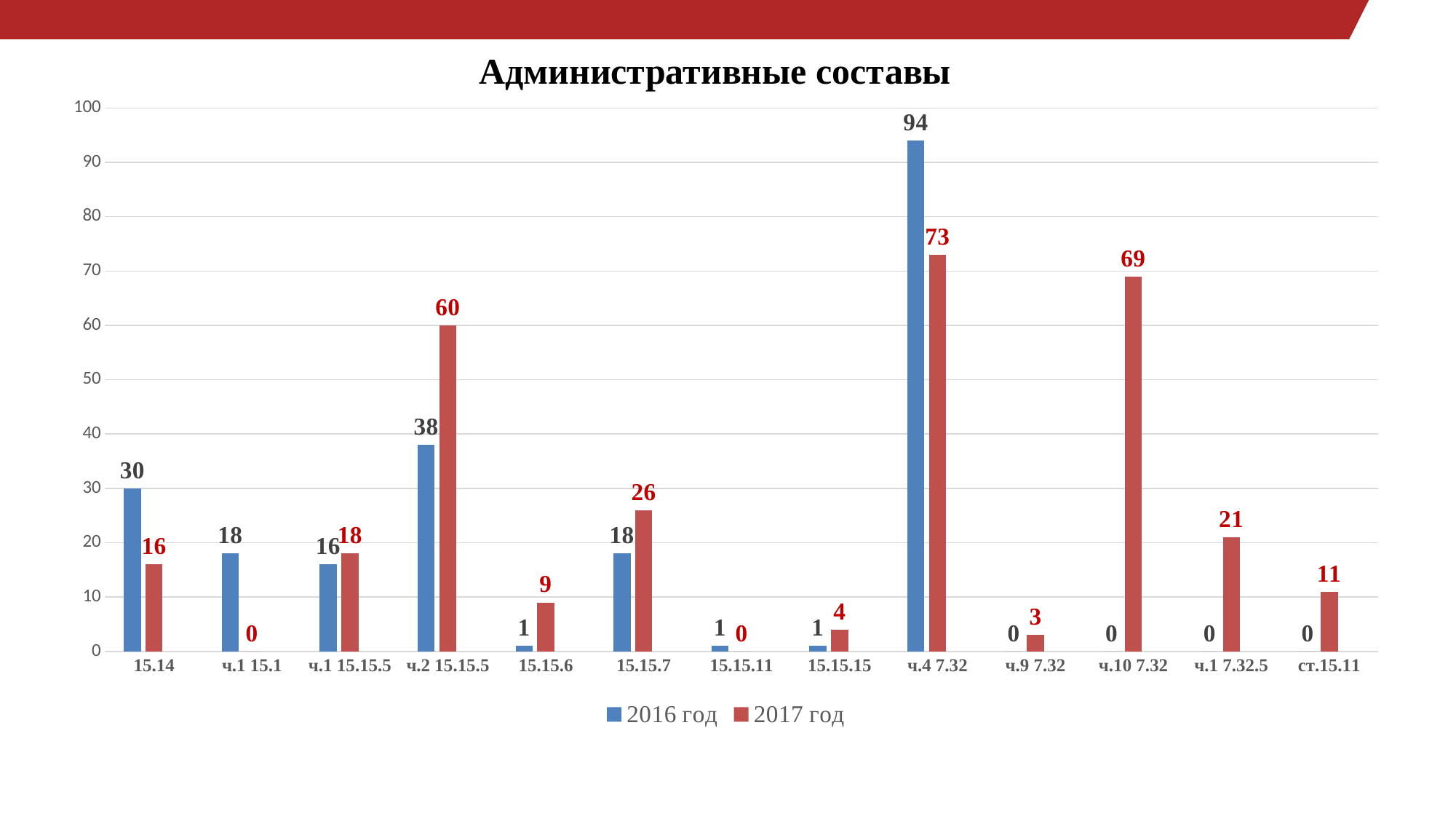
What is the difference between the 2016 год and 2017 год values for ч.4 7.32? 21 Is the 2017 год value for ч.10 7.32 greater or less than 60? greater What is the value for ч.10 7.32 in the 2017 год series? 69 What is the difference between the 2017 год and 2016 год values for ч.2 15.15.5? 22 What is the value for ч.4 7.32 in the 2016 год series? 94 How many series does the legend list? 2 How many categories are shown on the x axis? 13 Which is larger for 15.14: the 2016 год value or the 2017 год value? 2016 год What type of chart is shown on the slide? bar chart Which category has the highest value in the 2017 год series? ч.4 7.32 What is the value for 15.15.6 in the 2017 год series? 9 Which category has the highest value in the 2016 год series? ч.4 7.32